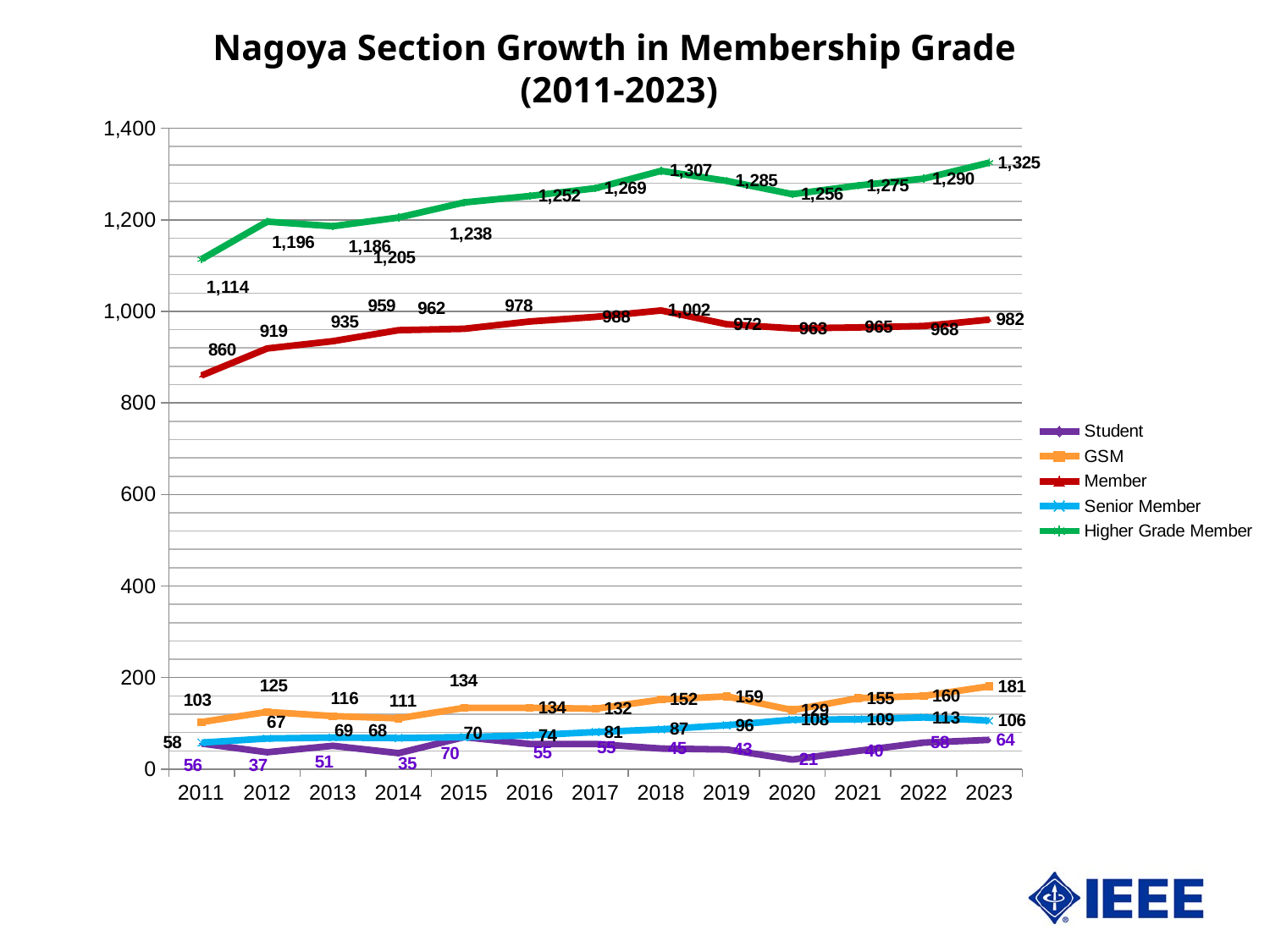
What is the Higher Grade Member value for 2023? 1,325 In which year is the Higher Grade Member value highest? 2023 What kind of chart is shown on the slide? line chart How many series does the legend list? 5 What is the Senior Member value for 2020? 108 In which year is the Student value lowest? 2020 How many years are plotted along the x axis? 13 In 2023, which is larger: the Senior Member value or the Student value? Senior Member What is the title of the chart? Nagoya Section Growth in Membership Grade (2011-2023) Is the Higher Grade Member value for 2011 greater or less than 1,200? less What is the Member value for 2011? 860 What is the difference between the GSM value in 2023 and in 2011? 78